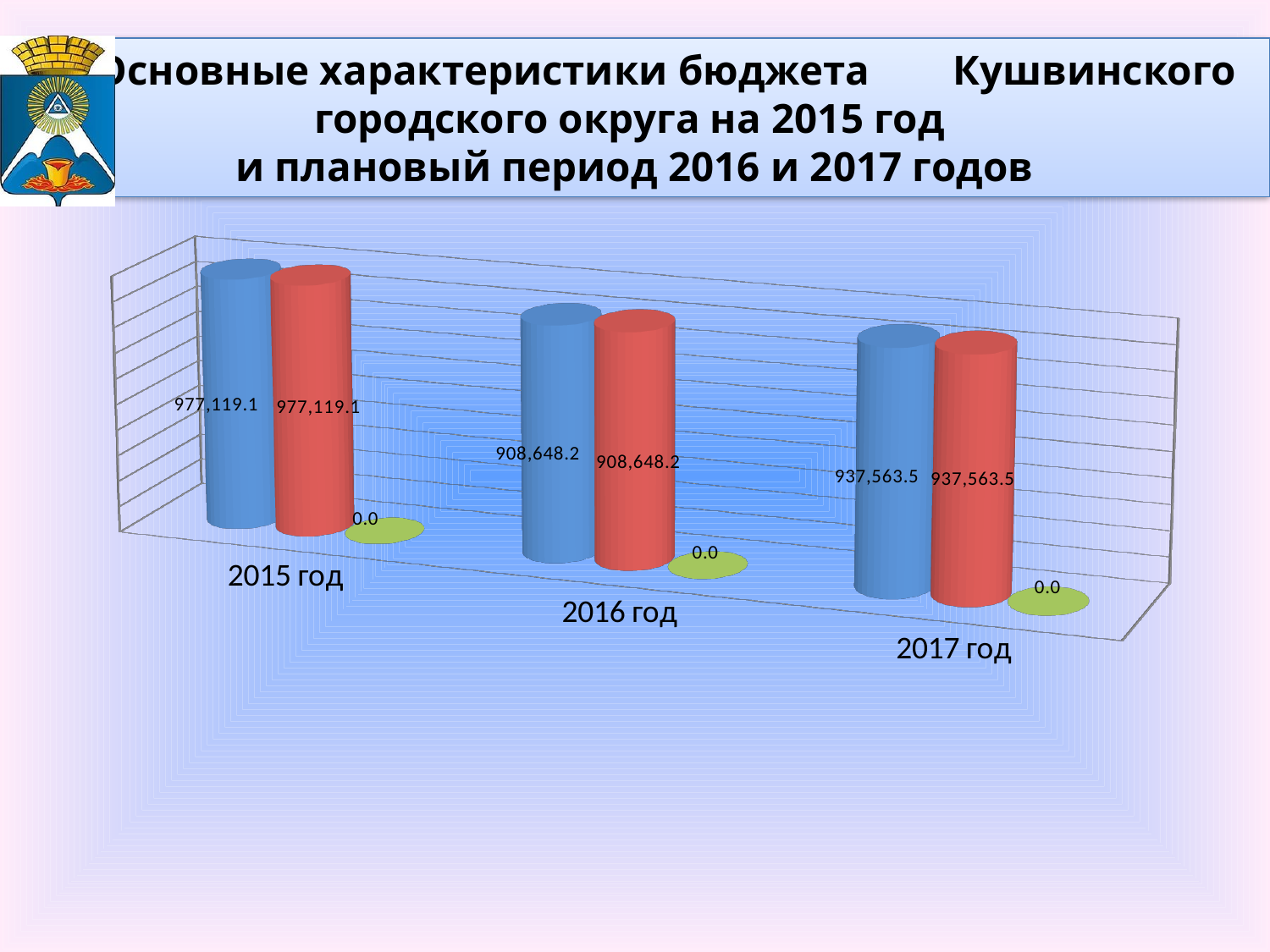
What colour is the bar that has a value of 0.0 in every year? green In which year is the red bar lowest? 2016 год What is the value of the blue bar for 2017 год? 937,563.5 Which is larger, the blue bar for 2016 год or the blue bar for 2017 год? 2017 год What is the value of the green bar for 2015 год? 0.0 What is the value of the red bar for 2016 год? 908,648.2 In which year is the blue bar highest? 2015 год What kind of chart is shown on the slide? bar chart How many years are shown on the x axis? 3 What is the difference between the blue bar values for 2015 год and 2016 год? 68,470.9 What is the value of the blue bar for 2015 год? 977,119.1 What is the difference between the red bar values for 2017 год and 2016 год? 28,915.3